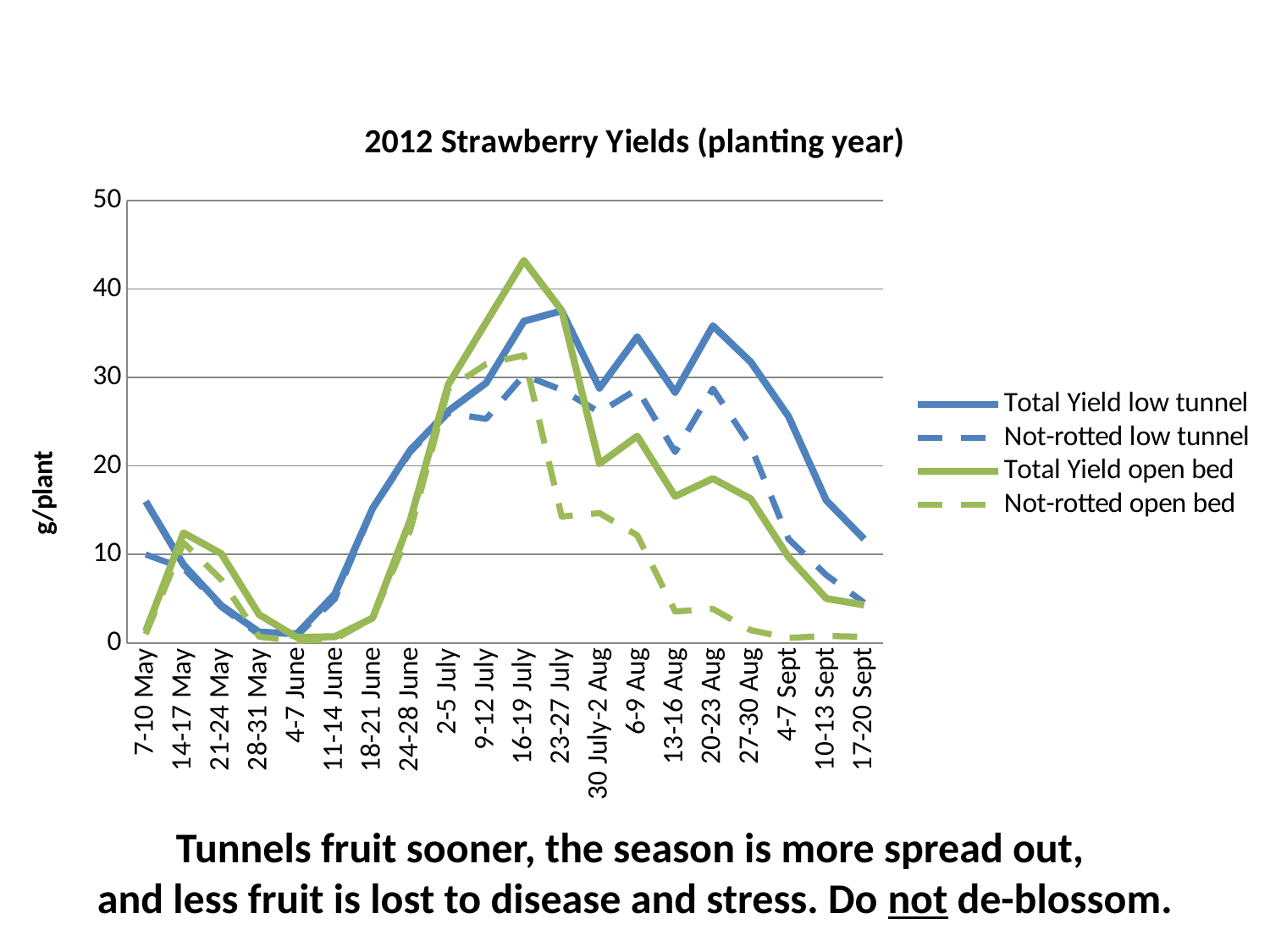
How many series does the legend list? 4 How many date categories are shown on the x axis? 20 Is the value for Total Yield open bed at 16-19 July greater or less than 40? greater At 7-10 May, which is larger: Total Yield low tunnel or Total Yield open bed? Total Yield low tunnel What kind of chart is shown on the slide? Line chart Is the value for Total Yield low tunnel at 7-10 May greater or less than 10? greater What is the label on the y axis? g/plant Does Total Yield open bed rise or fall from 16-19 July to 17-20 Sept? Fall Is the value for Not-rotted open bed at 4-7 Sept greater or less than 10? less Which series reaches the highest value on the chart? Total Yield open bed In which period does Total Yield open bed reach its highest value? 16-19 July What is the title of the chart? 2012 Strawberry Yields (planting year)